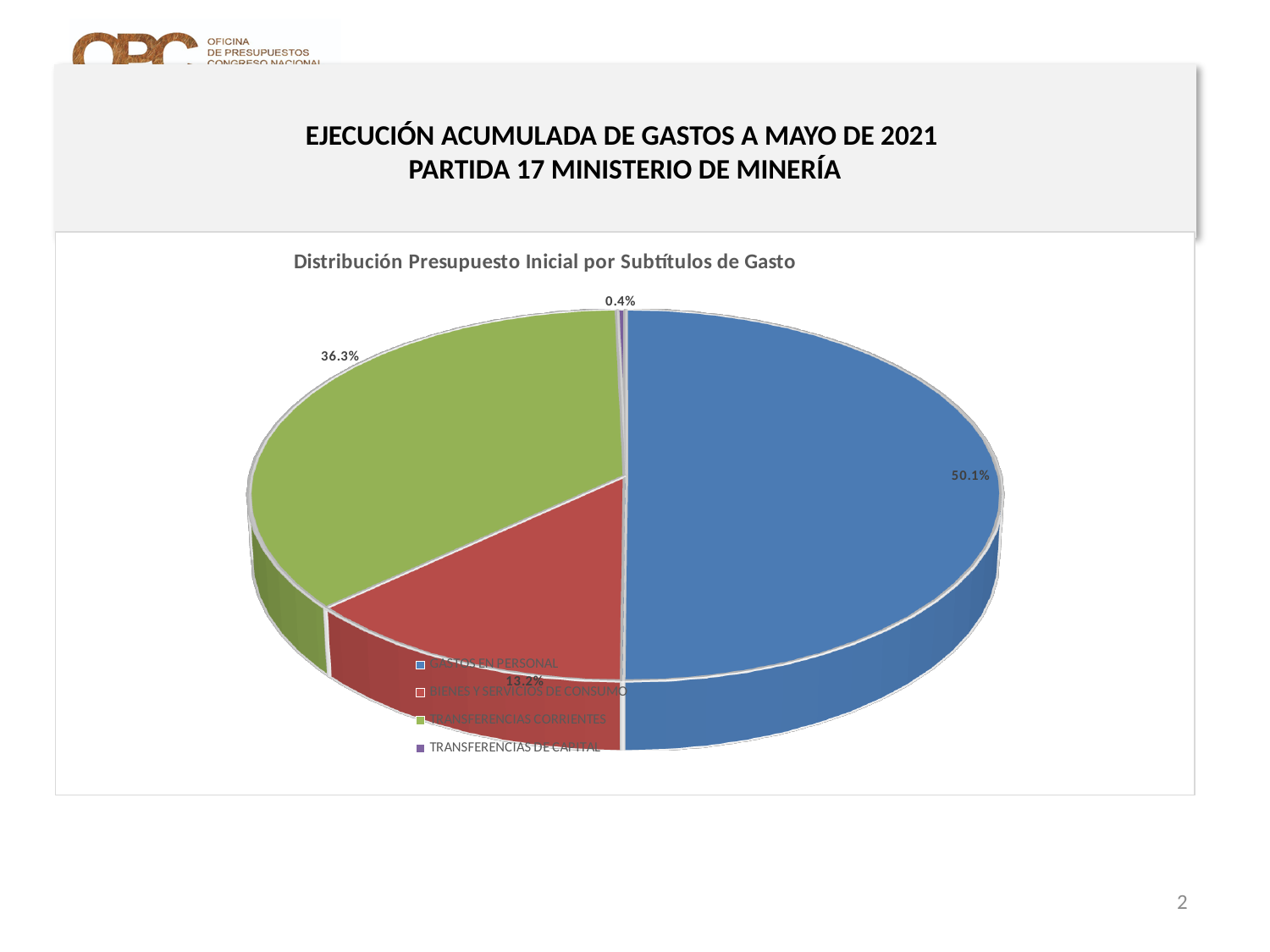
Which category has the smallest slice of the pie? TRANSFERENCIAS DE CAPITAL What share of the pie does TRANSFERENCIAS DE CAPITAL represent? 0.4% What is the difference in percentage points between GASTOS EN PERSONAL and TRANSFERENCIAS CORRIENTES? 13.8 What is the title of the chart? Distribución Presupuesto Inicial por Subtítulos de Gasto Which is larger, the share for TRANSFERENCIAS CORRIENTES or the share for BIENES Y SERVICIOS DE CONSUMO? TRANSFERENCIAS CORRIENTES What share of the pie does BIENES Y SERVICIOS DE CONSUMO represent? 13.2% Which category has the largest slice of the pie? GASTOS EN PERSONAL What share of the pie does TRANSFERENCIAS CORRIENTES represent? 36.3% What colour is the slice for GASTOS EN PERSONAL? blue How many categories does the legend list? 4 What kind of chart is shown on the slide? pie chart